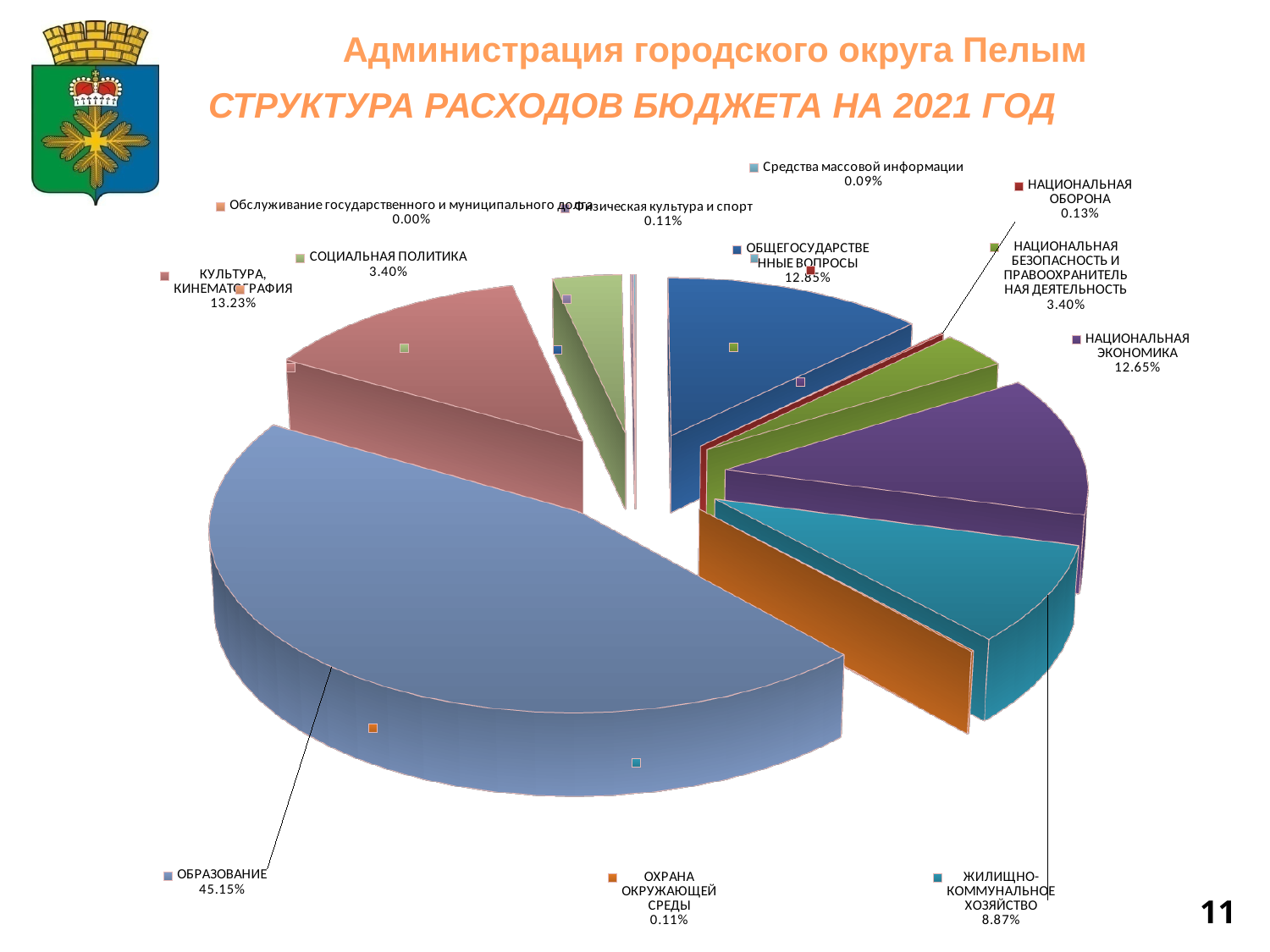
Which category has the smallest share of the budget expenditure? Обслуживание государственного и муниципального долга What is the difference in percentage points between the shares of ОБРАЗОВАНИЕ and КУЛЬТУРА, КИНЕМАТОГРАФИЯ? 31.92 Which category has the largest share of the budget expenditure? ОБРАЗОВАНИЕ How many categories are shown in the pie chart? 12 What share of the budget expenditure goes to ОБРАЗОВАНИЕ? 45.15% Which has a larger share: НАЦИОНАЛЬНАЯ ЭКОНОМИКА or ЖИЛИЩНО-КОММУНАЛЬНОЕ ХОЗЯЙСТВО? НАЦИОНАЛЬНАЯ ЭКОНОМИКА What share of the budget expenditure goes to КУЛЬТУРА, КИНЕМАТОГРАФИЯ? 13.23% What share of the budget expenditure goes to НАЦИОНАЛЬНАЯ ОБОРОНА? 0.13% What share of the budget expenditure goes to ЖИЛИЩНО-КОММУНАЛЬНОЕ ХОЗЯЙСТВО? 8.87% What type of chart is shown on the slide? Pie chart What share of the budget expenditure goes to НАЦИОНАЛЬНАЯ ЭКОНОМИКА? 12.65% What share of the budget expenditure goes to СОЦИАЛЬНАЯ ПОЛИТИКА? 3.40%